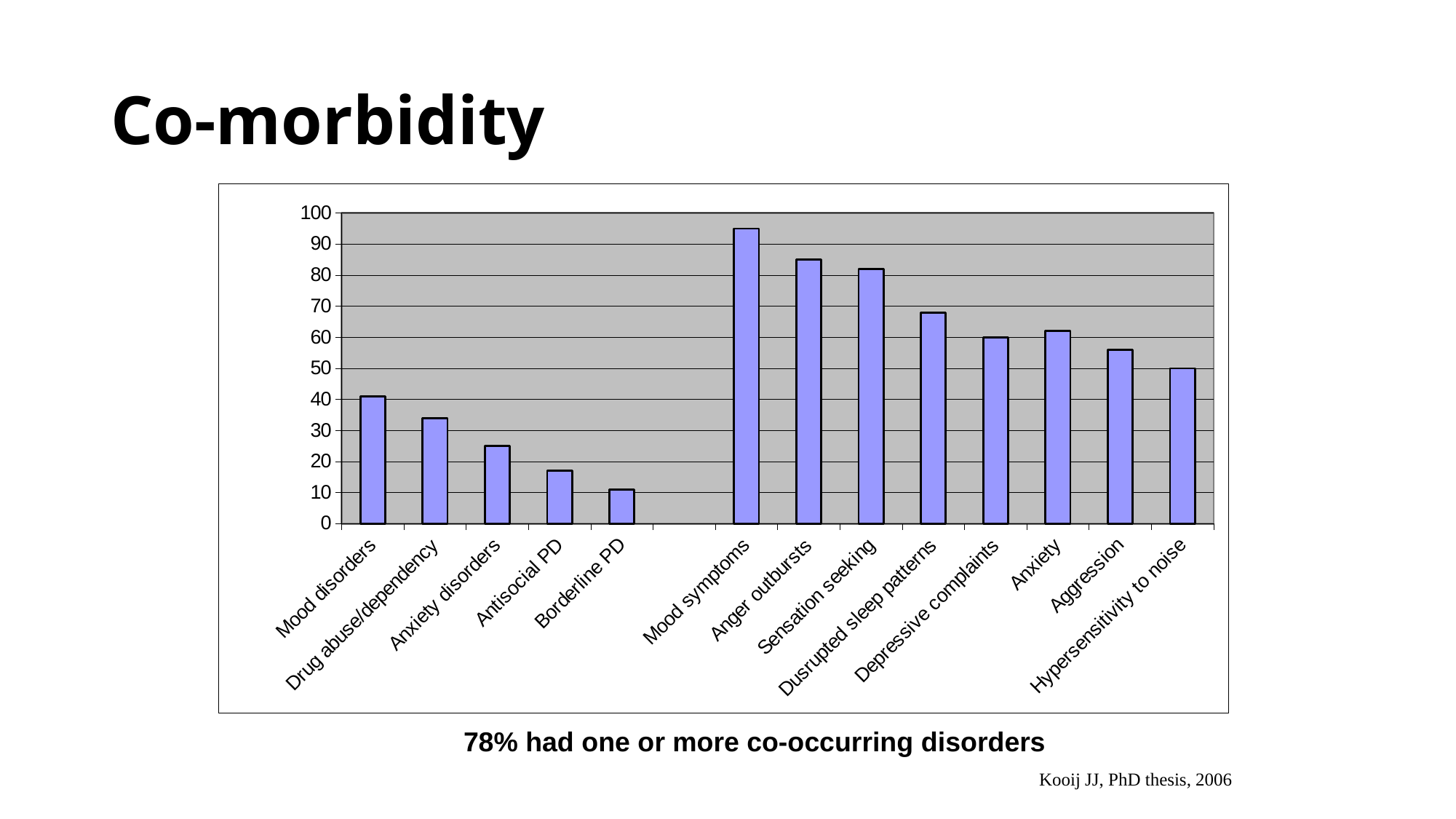
Is the value for Antisocial PD greater or less than 20? less Do the values of the first five bars (Mood disorders through Borderline PD) rise or fall from left to right? fall According to the text below the chart, what percentage had one or more co-occurring disorders? 78% Is the value for Mood symptoms greater or less than 90? greater Is the value for Anxiety disorders greater or less than 30? less Which category has the lowest bar in the chart? Borderline PD What kind of chart is shown on the slide? bar chart Which is larger, the value for Sensation seeking or the value for Disrupted sleep patterns? Sensation seeking How many bars (categories) are plotted in the chart? 13 Which is larger, the value for Mood disorders or the value for Drug abuse/dependency? Mood disorders Which category has the highest bar in the chart? Mood symptoms